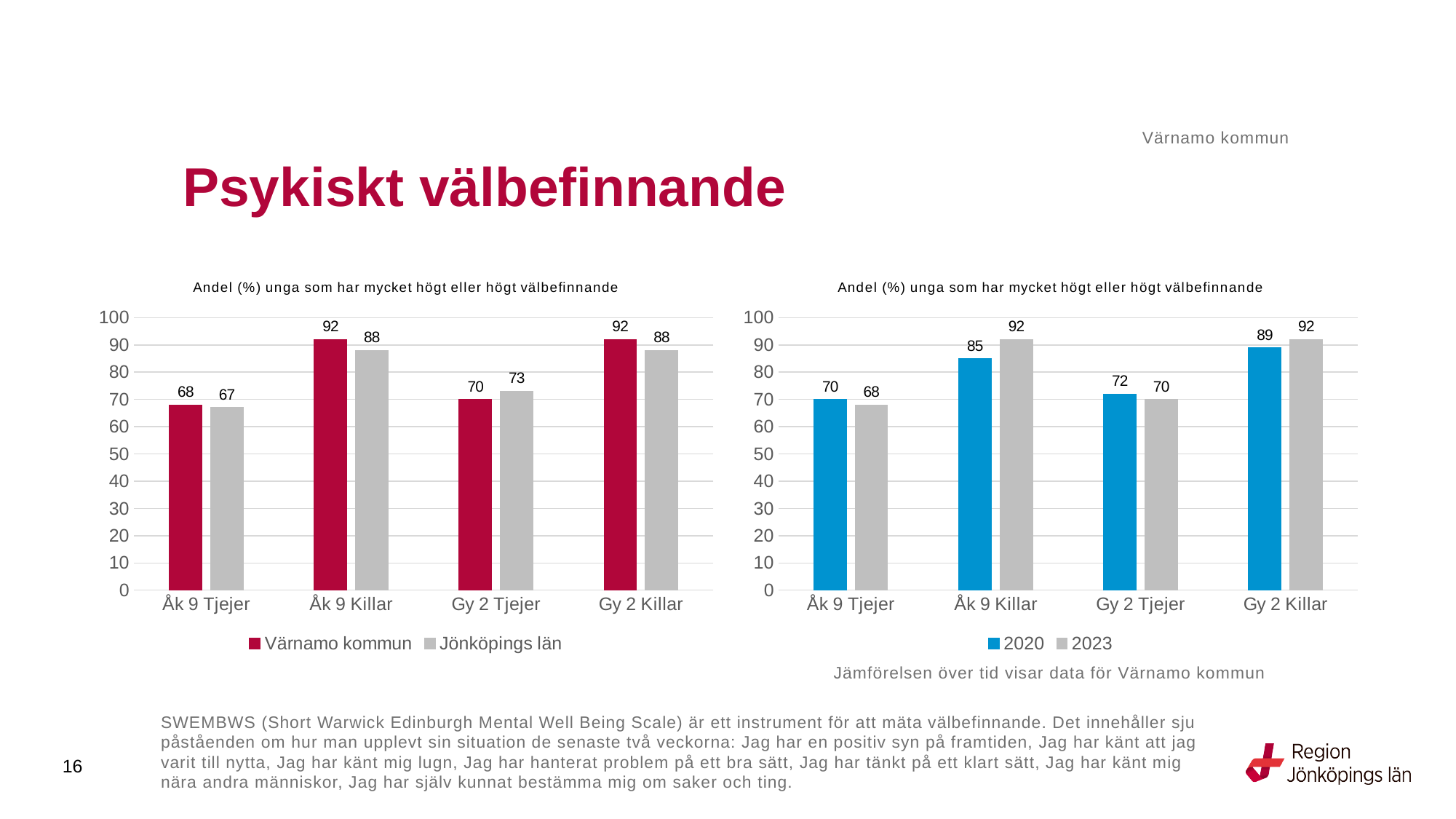
How many series does the legend of the right chart list? 2 In the left chart, what is the value for Jönköpings län for Gy 2 Tjejer? 73 In the right chart, which category has the highest value for 2020? Gy 2 Killar In the left chart, which category has the lowest value for Jönköpings län? Åk 9 Tjejer In the right chart, which is larger for Gy 2 Tjejer: the 2020 value or the 2023 value? 2020 How many categories are shown on the x axis of the left chart? 4 In the right chart, what is the value for 2020 for Åk 9 Killar? 85 In the right chart, what is the difference between the 2023 and 2020 values for Åk 9 Killar? 7 In the right chart, what is the value for 2023 for Gy 2 Killar? 92 What kind of chart is the left chart? Bar chart In the left chart, what is the difference between Värnamo kommun and Jönköpings län for Gy 2 Killar? 4 In the left chart, what is the value for Värnamo kommun for Åk 9 Killar? 92